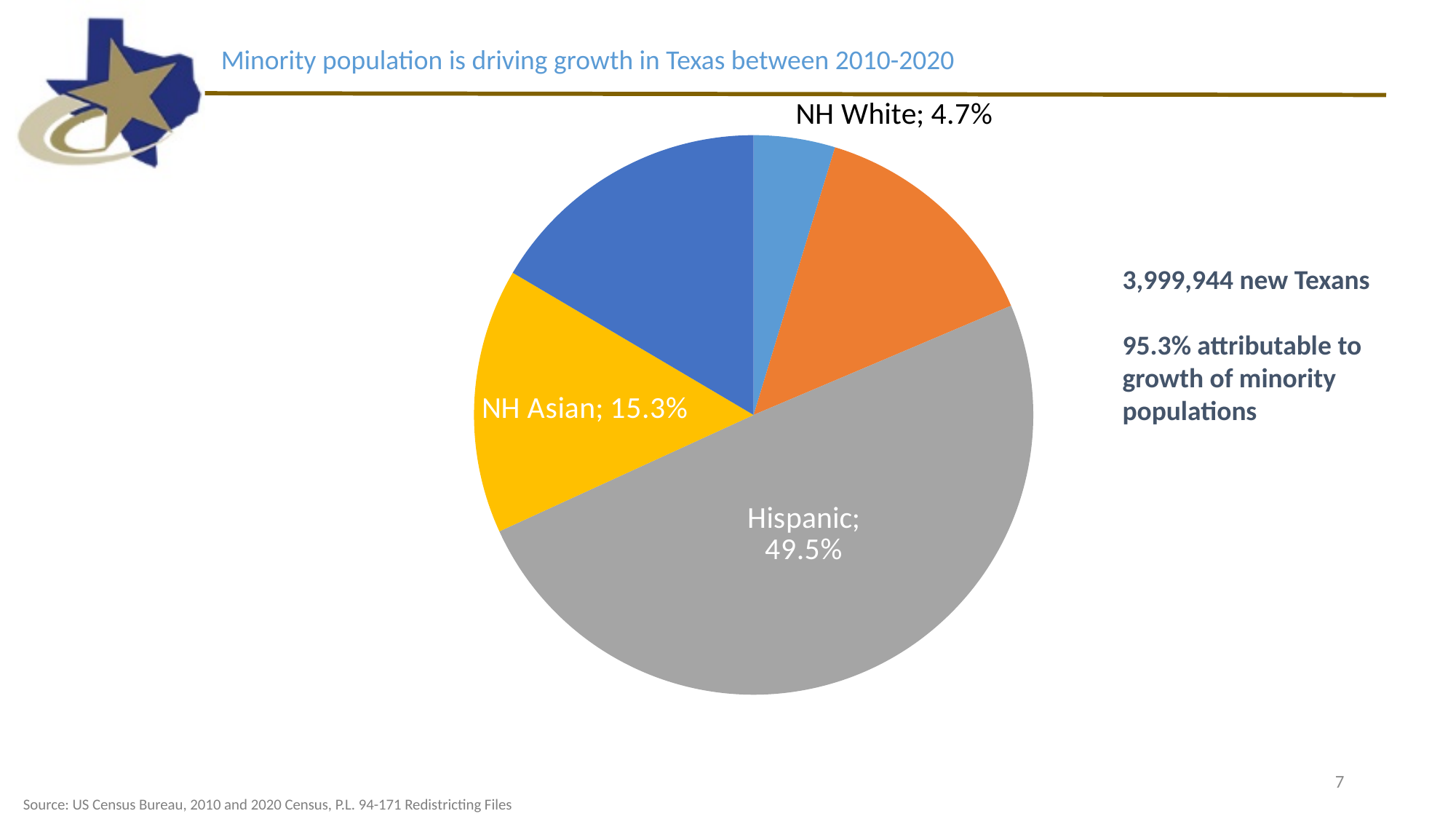
What is the difference between the NH Asian share and the NH White share? 10.6% Which is larger, the NH Asian slice or the NH White slice? NH Asian What share of the pie does the Hispanic slice represent? 49.5% What is the value shown for NH Asian? 15.3% What is the title of the slide containing the pie chart? Minority population is driving growth in Texas between 2010-2020 What kind of chart is shown on the slide? pie chart Which labeled slice of the pie is the largest? Hispanic How many slices does the pie chart have? 5 What is the difference between the Hispanic share and the NH Asian share? 34.2% What colour is the Hispanic slice of the pie? gray What is the value shown for NH White? 4.7% Which slice of the pie is the smallest? NH White